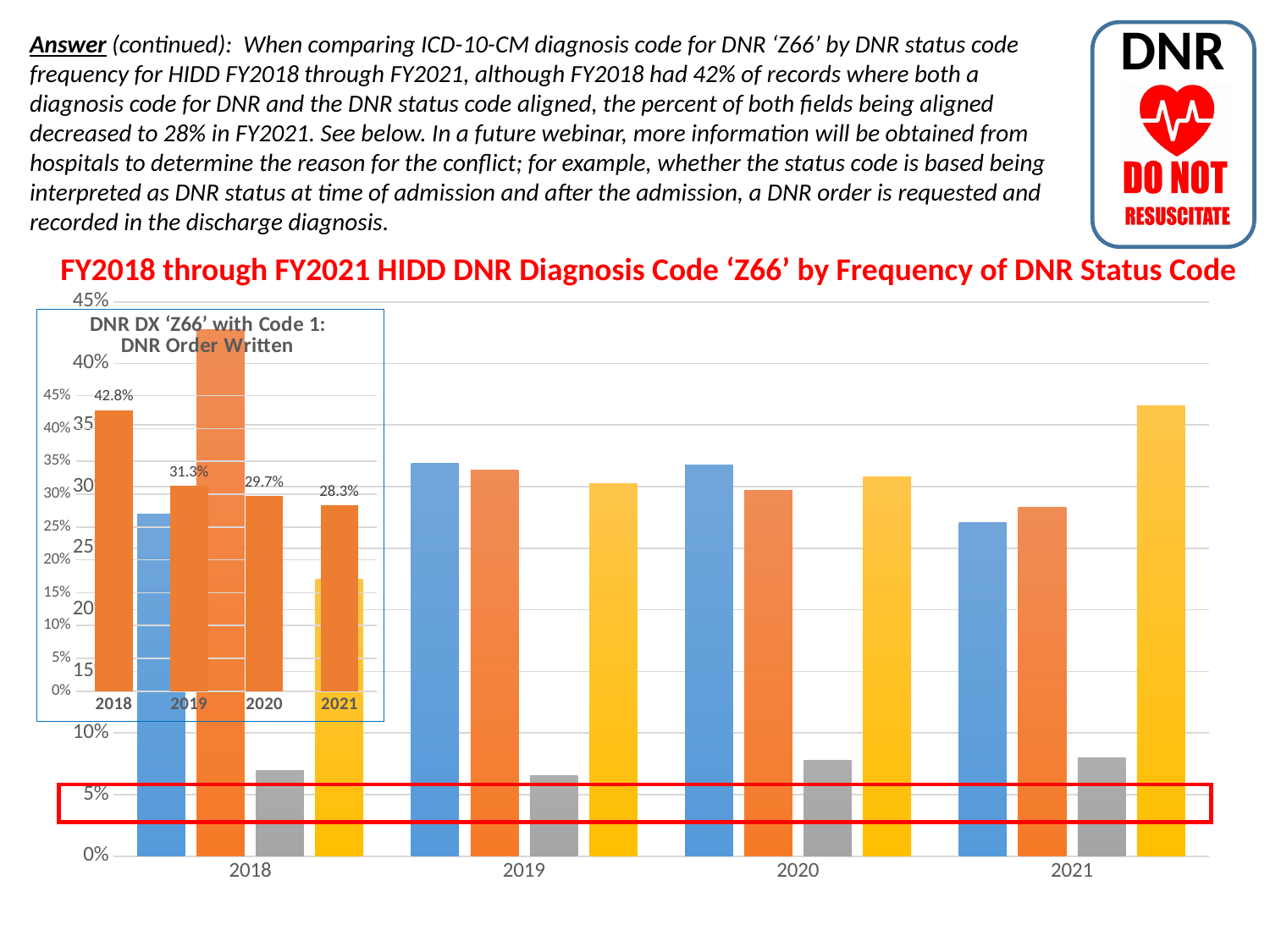
In the large chart titled "FY2018 through FY2021 HIDD DNR Diagnosis Code 'Z66' by Frequency of DNR Status Code", is the value of the yellow bar for 2018 greater or less than 20%? greater In the inset chart titled "DNR DX 'Z66' with Code 1: DNR Order Written", what is the value for 2018? 42.8% In the inset chart titled "DNR DX 'Z66' with Code 1: DNR Order Written", what is the value for 2021? 28.3% In the inset chart titled "DNR DX 'Z66' with Code 1: DNR Order Written", which year has the highest value? 2018 What kind of chart is the large chart titled "FY2018 through FY2021 HIDD DNR Diagnosis Code 'Z66' by Frequency of DNR Status Code"? bar chart In the inset chart titled "DNR DX 'Z66' with Code 1: DNR Order Written", what is the value for 2019? 31.3% In the inset chart titled "DNR DX 'Z66' with Code 1: DNR Order Written", how many years are plotted? 4 In the inset chart titled "DNR DX 'Z66' with Code 1: DNR Order Written", do the values rise or fall from 2018 to 2021? fall In the inset chart titled "DNR DX 'Z66' with Code 1: DNR Order Written", what is the difference between the 2018 and 2021 values? 14.5% In the large chart titled "FY2018 through FY2021 HIDD DNR Diagnosis Code 'Z66' by Frequency of DNR Status Code", is the value of the orange bar for 2018 greater or less than 40%? greater In the inset chart titled "DNR DX 'Z66' with Code 1: DNR Order Written", which year has the lowest value? 2021 In the large chart titled "FY2018 through FY2021 HIDD DNR Diagnosis Code 'Z66' by Frequency of DNR Status Code", is the value of the gray bar for 2019 greater or less than 10%? less